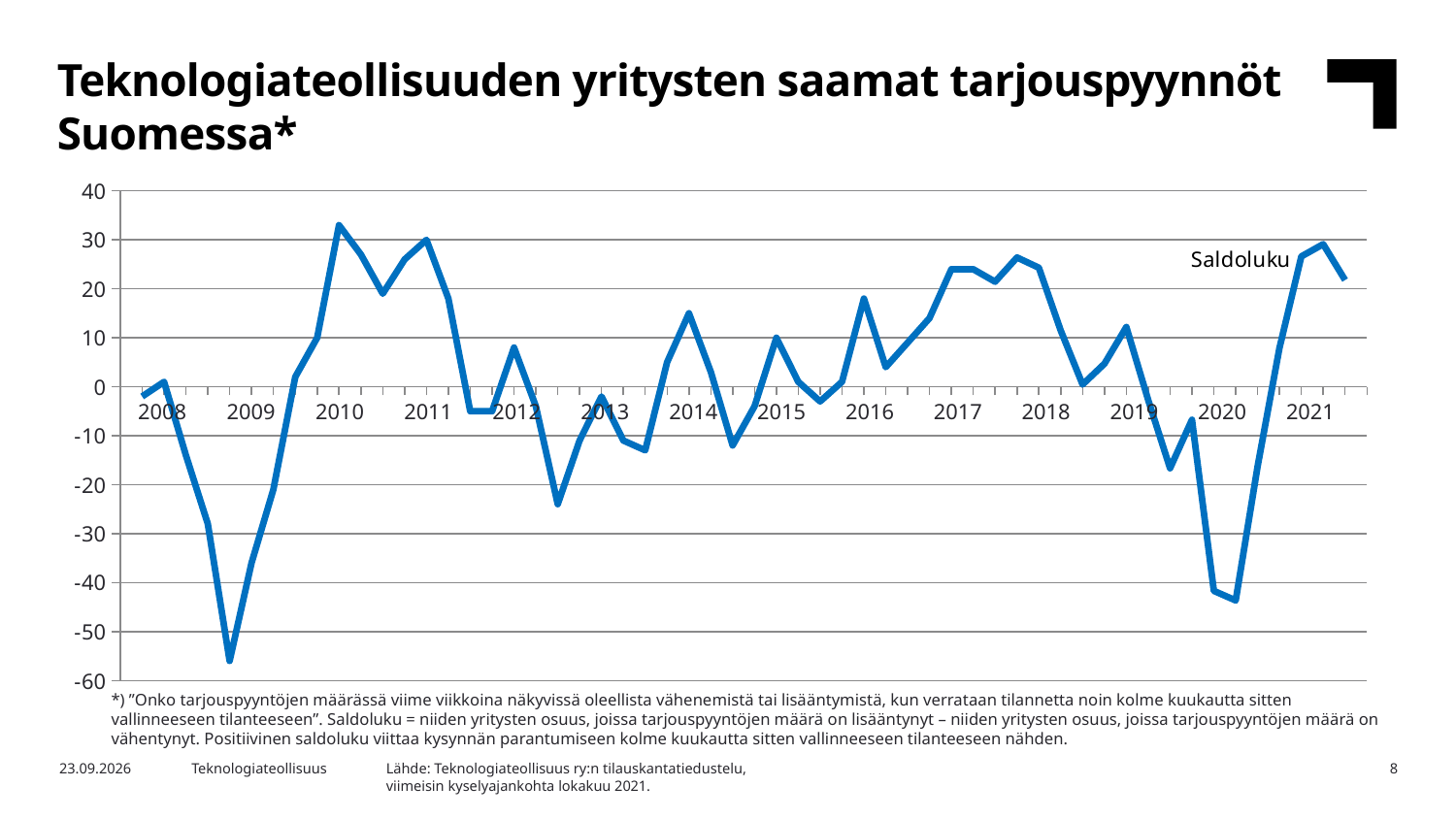
Is the lowest value of the line in 2013 greater or less than -20? greater In which year does the line reach its lowest point? 2009 How many series does the chart plot? 1 Which is larger, the peak value in 2010 or the peak value in 2014? 2010 Is the peak value of the line in 2014 greater or less than 10? greater What is the name of the series plotted on the chart? Saldoluku Is the lowest value of the line in 2009 greater or less than -50? less Does the line rise or fall between the low point in 2020 and the peak in 2021? rise What kind of chart is shown on the slide? line chart How many years are labelled on the x axis of the chart? 14